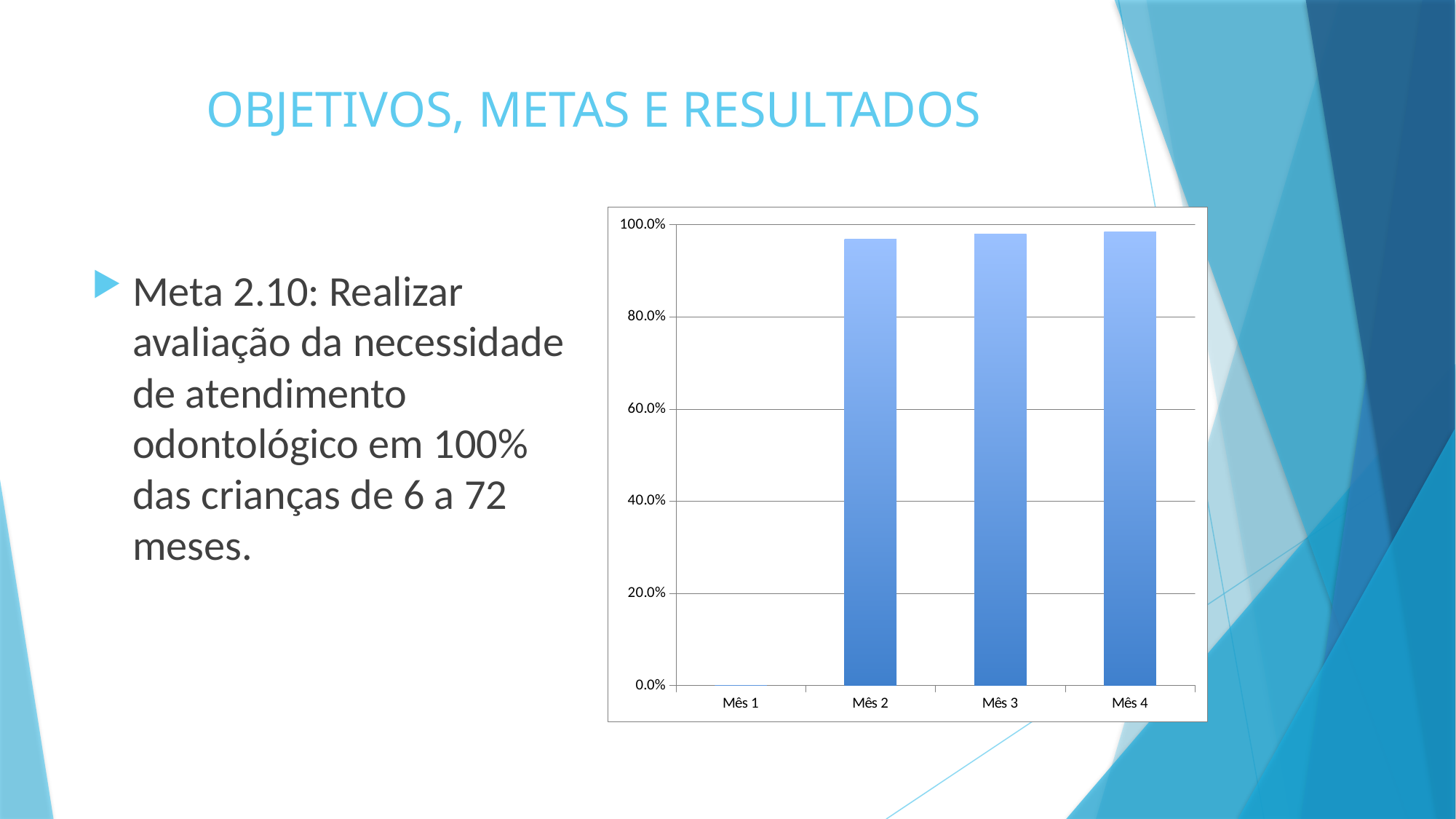
Is the value for Mês 3 greater or less than 100.0%? less What kind of chart is shown on the slide? Bar chart What is the label of the last category on the x axis? Mês 4 Is the value for Mês 1 greater or less than 20.0%? less What is the highest value shown on the y axis of the chart? 100.0% How many categories are shown on the x axis of the chart? 4 Which has the larger value, Mês 1 or Mês 2? Mês 2 Is the value for Mês 4 greater or less than 60.0%? greater Which category has the lowest value in the chart? Mês 1 Which has the larger value, Mês 3 or Mês 1? Mês 3